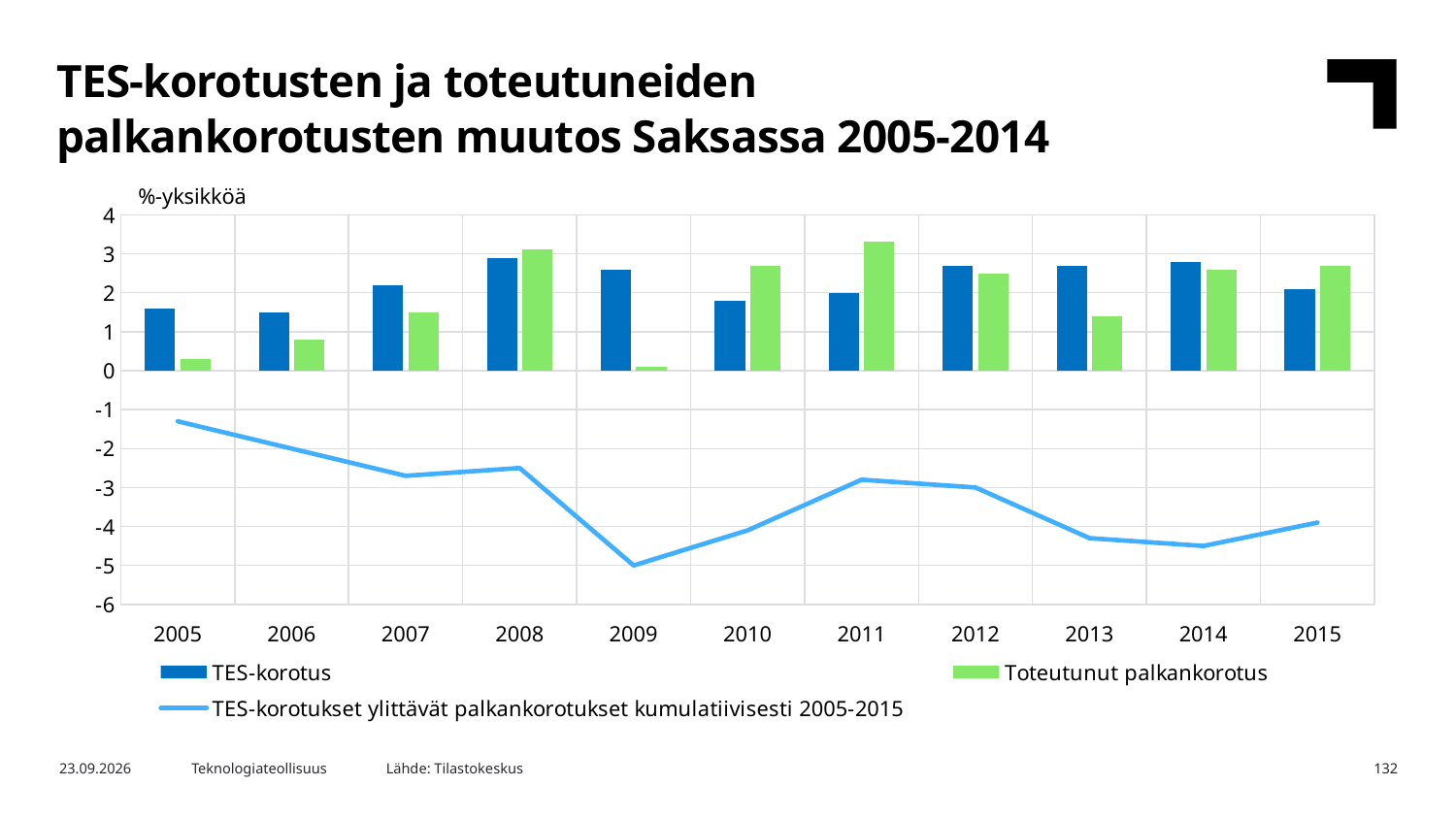
Is the Toteutunut palkankorotus value for 2011 greater or less than 3? greater Which year has the lowest Toteutunut palkankorotus bar? 2009 In 2013, which is larger: TES-korotus or Toteutunut palkankorotus? TES-korotus In which year does the cumulative line (TES-korotukset ylittävät palkankorotukset kumulatiivisesti 2005-2015) reach its lowest point? 2009 How many years are shown on the x axis? 11 How many series does the legend list? 3 What kind of chart is shown on the slide? Combined bar and line chart In which year is the cumulative line at its highest point? 2005 In 2008, which is larger: TES-korotus or Toteutunut palkankorotus? Toteutunut palkankorotus Which year has the highest Toteutunut palkankorotus bar? 2011 Does the cumulative line rise or fall from 2005 to 2009? fall Is the cumulative line value for 2009 greater or less than -4? less